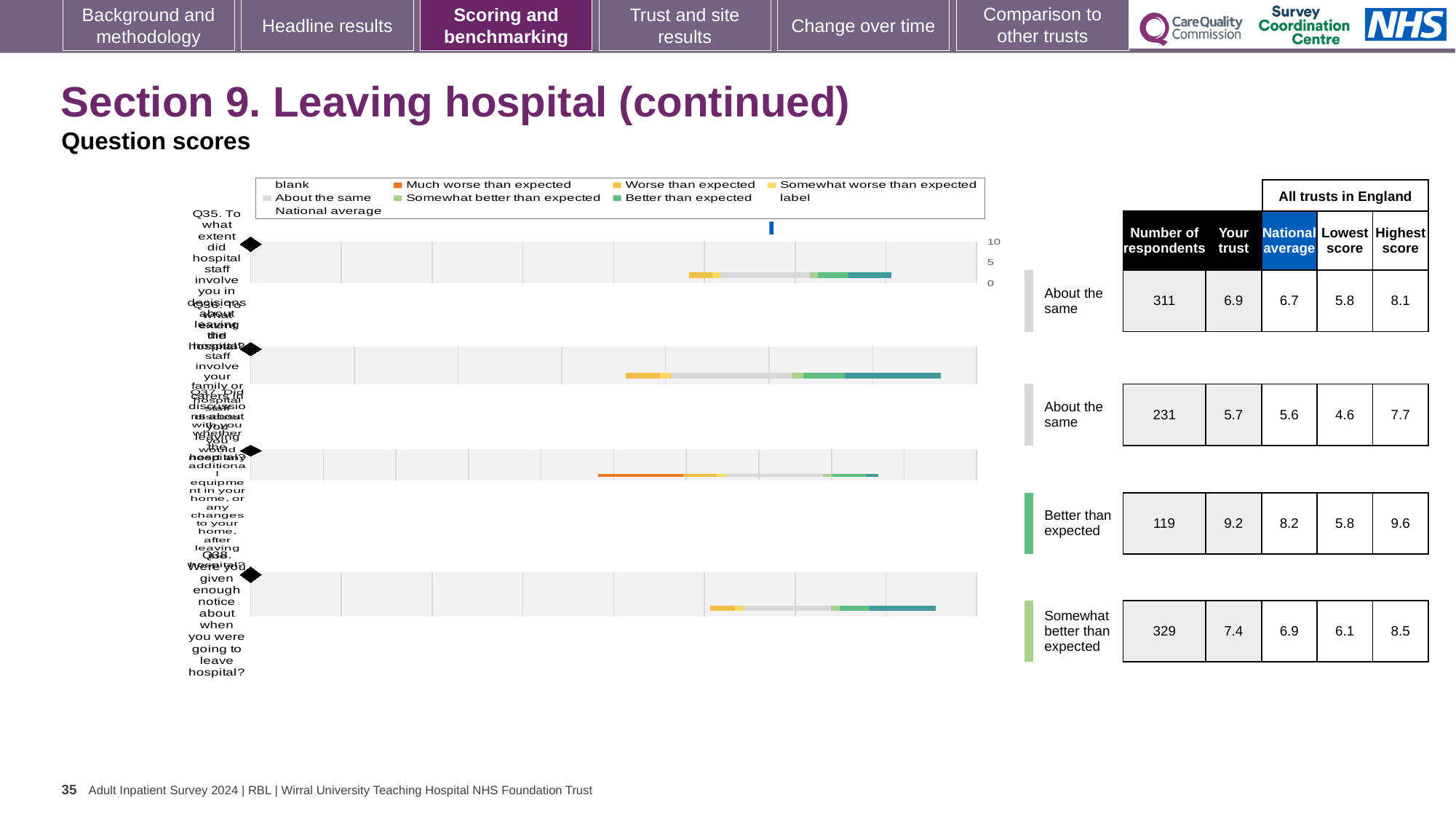
What benchmark category is shown for Q37 in the table? Better than expected In the table, what is the lowest score across all trusts in England for Q36? 4.6 In the table, what is the 'Your trust' score for Q35 (involving you in decisions about leaving hospital)? 6.9 How many questions (Q35 to Q38) are plotted in the chart? 4 Is the 'Your trust' score for Q38 larger or smaller than the national average for Q38? larger Which question has the highest 'Your trust' score in the table? Q37 What kind of chart is used to show the question scores on this slide? bar chart What is the difference between the 'Your trust' score and the national average for Q37? 1.0 In the table, what is the national average for Q36 (involving family or carers in discussions about leaving hospital)? 5.6 Which question has the fewest respondents in the table? Q37 In the table, what is the highest score across all trusts in England for Q38 (enough notice about leaving hospital)? 8.5 In the table, how many respondents are listed for Q37 (discussing additional equipment or changes to your home)? 119